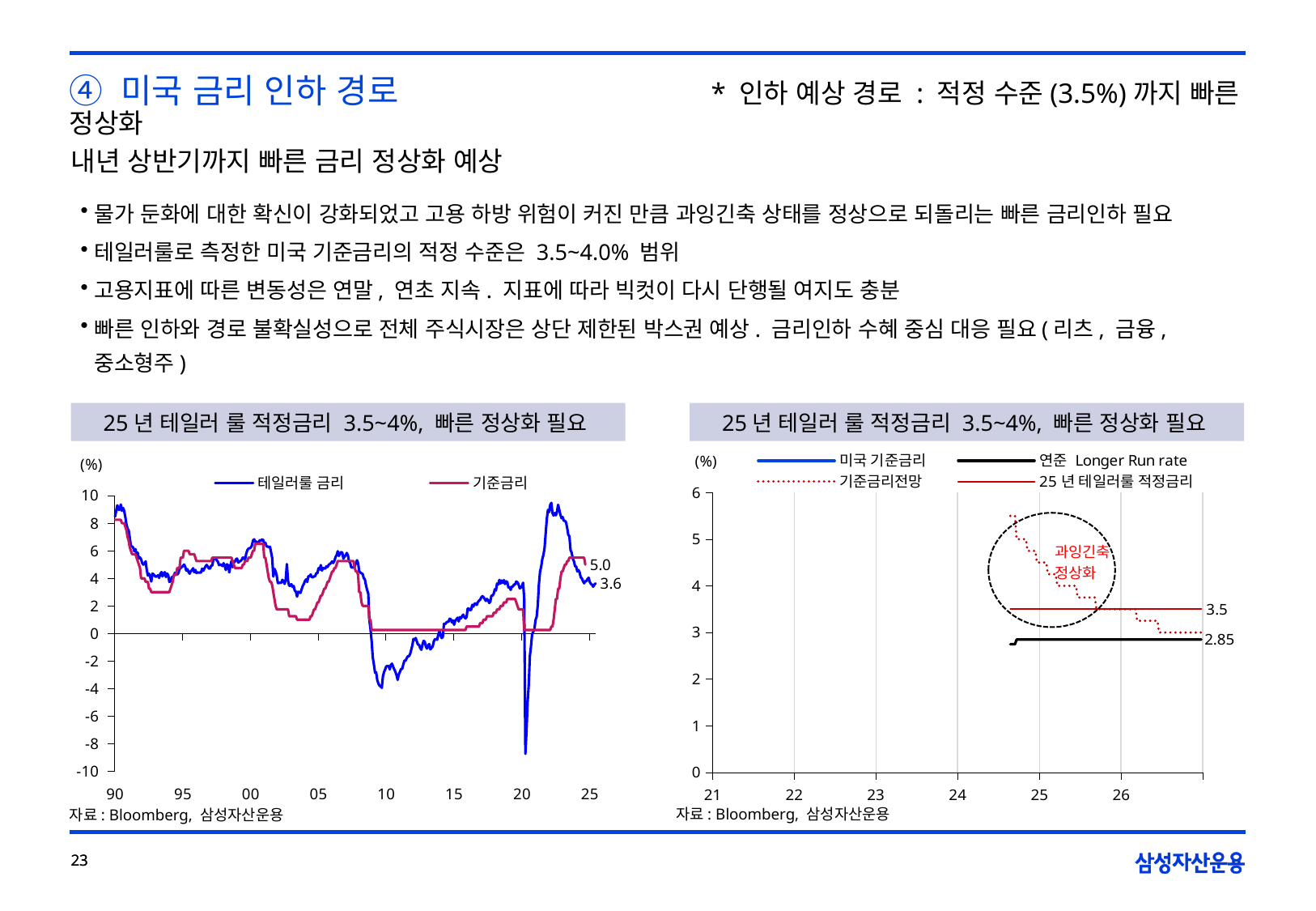
In the left chart, what is the difference between the labelled latest values of 기준금리 (5.0) and 테일러룰 금리 (3.6)? 1.4 In the right chart, what is the labelled value of 25년 테일러룰 적정금리? 3.5 In the right chart, what is the difference between the 25년 테일러룰 적정금리 (3.5) and the 연준 Longer Run rate (2.85)? 0.65 What type of chart is the left chart on the slide? line chart In the right chart, what text is written inside the dashed circle? 과잉긴축 정상화 In the left chart, is the lowest value of 테일러룰 금리 around 2020 greater or less than -5? less In the left chart, which series has the higher labelled latest value, 기준금리 or 테일러룰 금리? 기준금리 How many series does the legend of the left chart list? 2 In the left chart, what is the labelled latest value of 테일러룰 금리? 3.6 How many series does the legend of the right chart list? 4 In the left chart, what is the labelled latest value of 기준금리? 5.0 In the right chart, what is the labelled value of 연준 Longer Run rate? 2.85